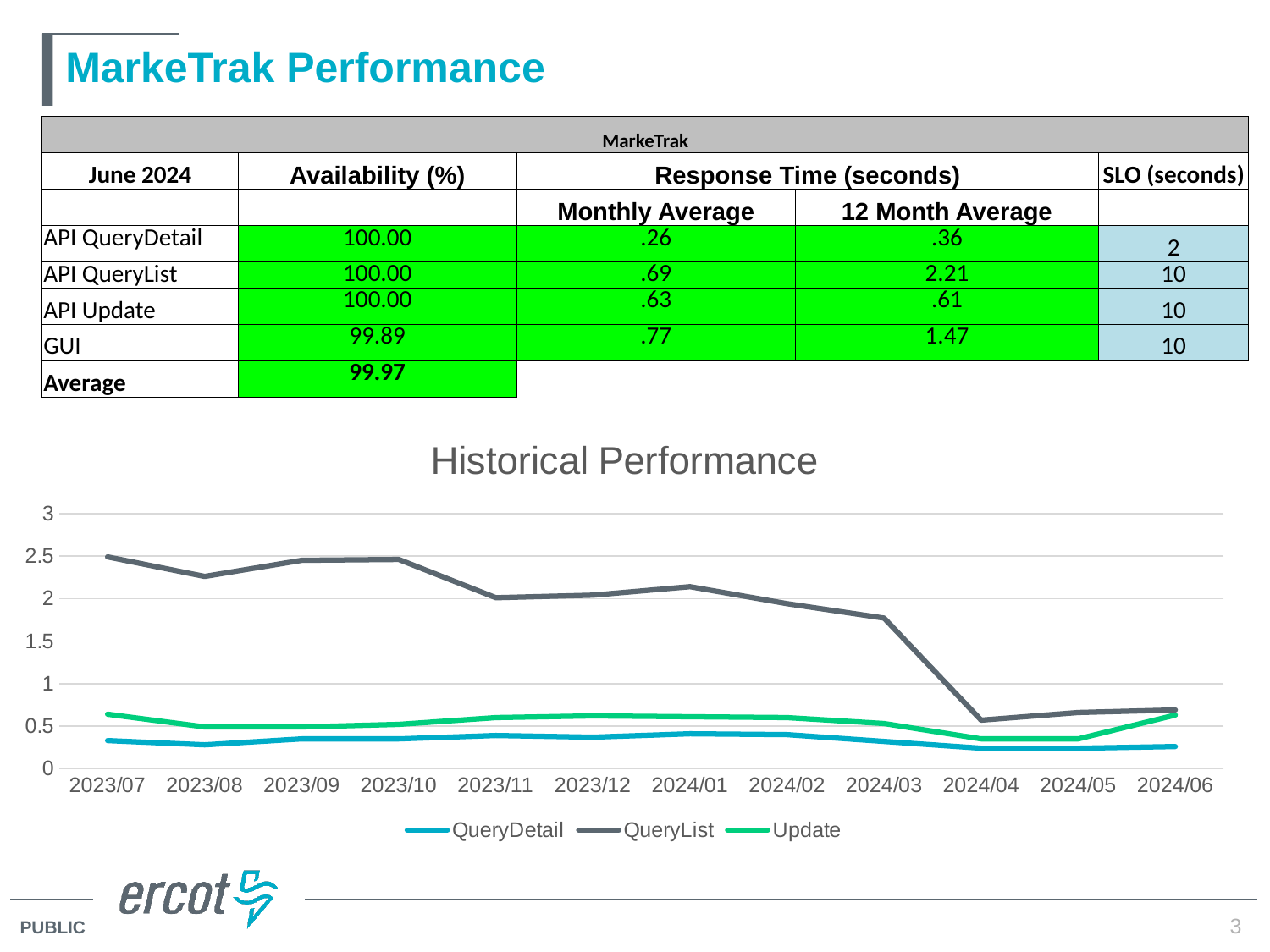
In the Historical Performance chart, does the QueryList series rise or fall from 2023/07 to 2024/06? fall In the Historical Performance chart, which is larger at 2024/01, QueryList or QueryDetail? QueryList In the Historical Performance chart, is the QueryList value for 2023/07 greater or less than 2? greater In the Historical Performance chart, which series has the lowest value at 2024/06? QueryDetail What is the title of the line chart on the slide? Historical Performance How many series does the legend of the Historical Performance chart list? 3 In the Historical Performance chart, is the QueryList value for 2024/04 greater or less than 1? less How many months are plotted along the x axis of the Historical Performance chart? 12 In the Historical Performance chart, which series has the highest value at 2023/07? QueryList In the Historical Performance chart, is the QueryList value for 2024/03 greater or less than 1.5? greater What kind of chart is the Historical Performance chart? line chart